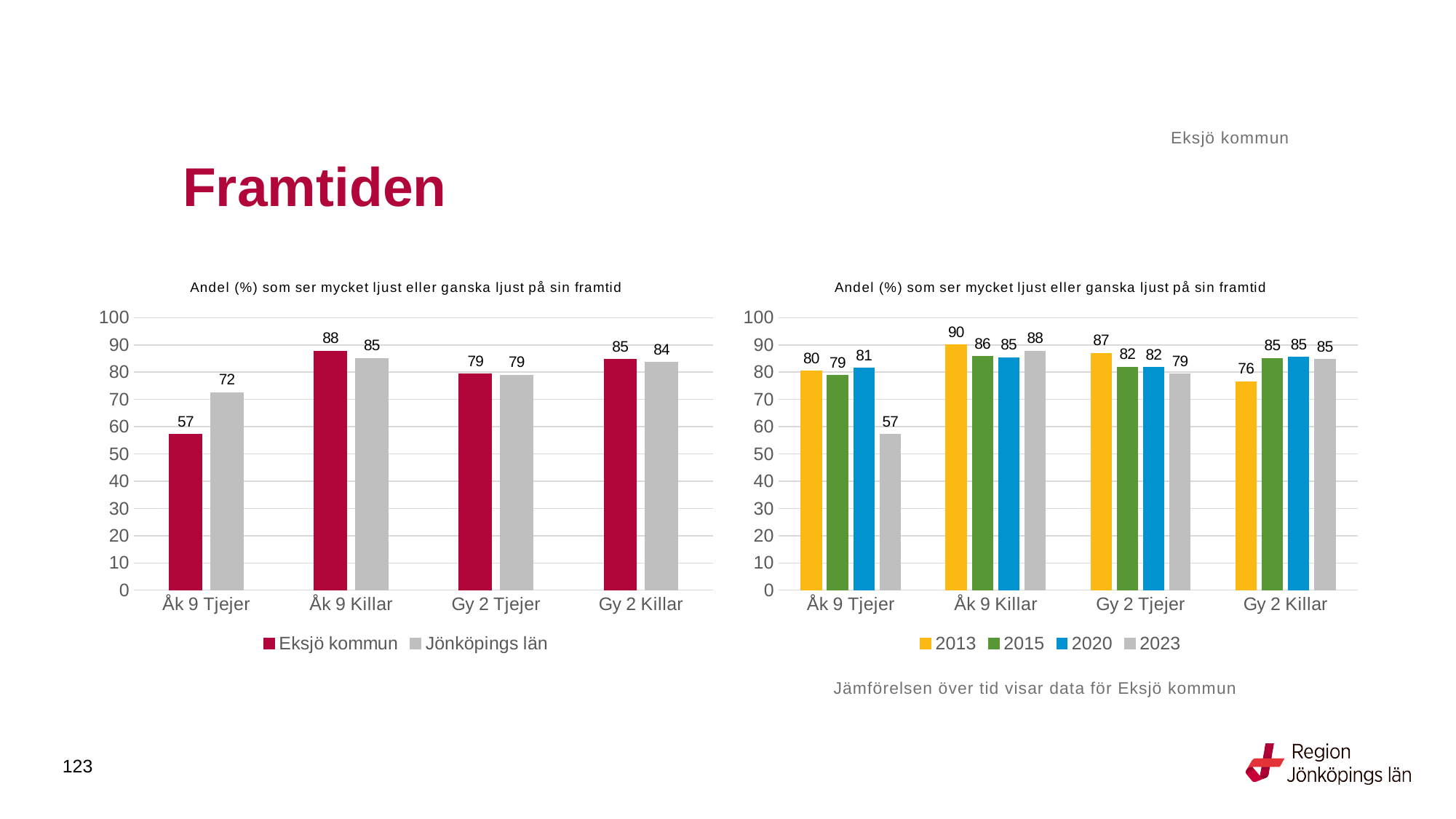
In the right chart, how many series does the legend list? 4 What kind of chart is the left chart? Bar chart In the left chart, what is the value for Eksjö kommun for Åk 9 Tjejer? 57 In the left chart, how many series does the legend list? 2 In the right chart, what is the value for 2013 for Åk 9 Killar? 90 In the right chart, which category has the lowest value for 2013? Gy 2 Killar In the right chart, what is the value for 2023 for Åk 9 Tjejer? 57 In the right chart, what is the difference between 2013 and 2023 for Gy 2 Tjejer? 8 In the left chart, which category has the highest value for Eksjö kommun? Åk 9 Killar In the right chart, which is larger for Gy 2 Killar: 2013 or 2015? 2015 In the left chart, what is the value for Jönköpings län for Gy 2 Killar? 84 In the left chart, what is the difference between Jönköpings län and Eksjö kommun for Åk 9 Tjejer? 15